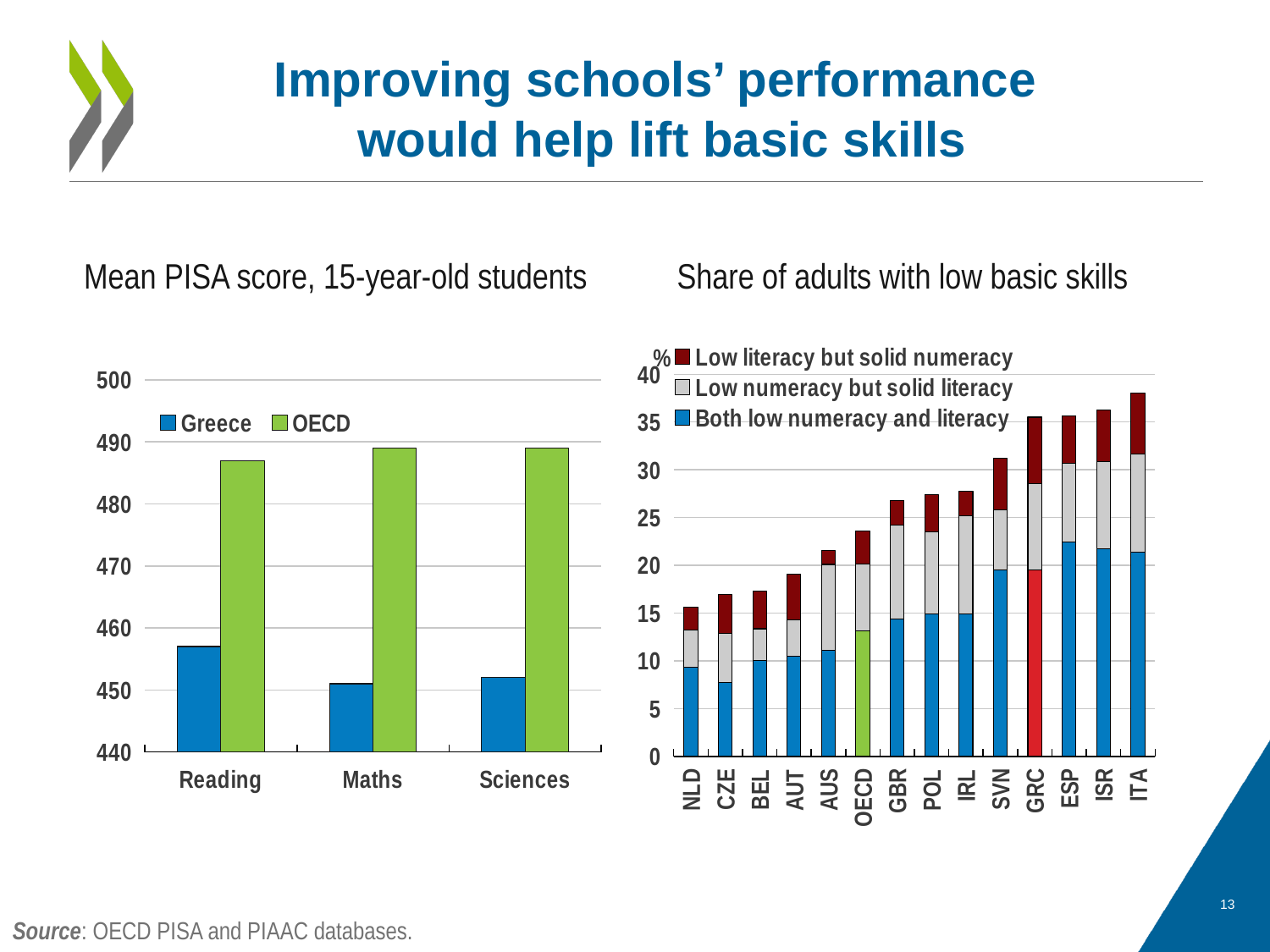
In the 'Mean PISA score, 15-year-old students' chart, in which subject does Greece have its highest score? Reading In the 'Share of adults with low basic skills' chart, which country has the highest total bar? ITA In the 'Mean PISA score, 15-year-old students' chart, is the OECD value for Sciences greater or less than 480? greater How many subject categories are shown on the x axis of the 'Mean PISA score, 15-year-old students' chart? 3 In the 'Mean PISA score, 15-year-old students' chart, which is larger for Reading: Greece or OECD? OECD In the 'Mean PISA score, 15-year-old students' chart, is the Greece value for Maths greater or less than 460? less What kind of chart is the 'Mean PISA score, 15-year-old students' chart? bar chart In the 'Share of adults with low basic skills' chart, is the total bar for GRC greater or less than 30? greater How many countries or groups are shown on the x axis of the 'Share of adults with low basic skills' chart? 14 How many series does the legend of the 'Mean PISA score, 15-year-old students' chart list? 2 How many series does the legend of the 'Share of adults with low basic skills' chart list? 3 What kind of chart is the 'Share of adults with low basic skills' chart? stacked bar chart